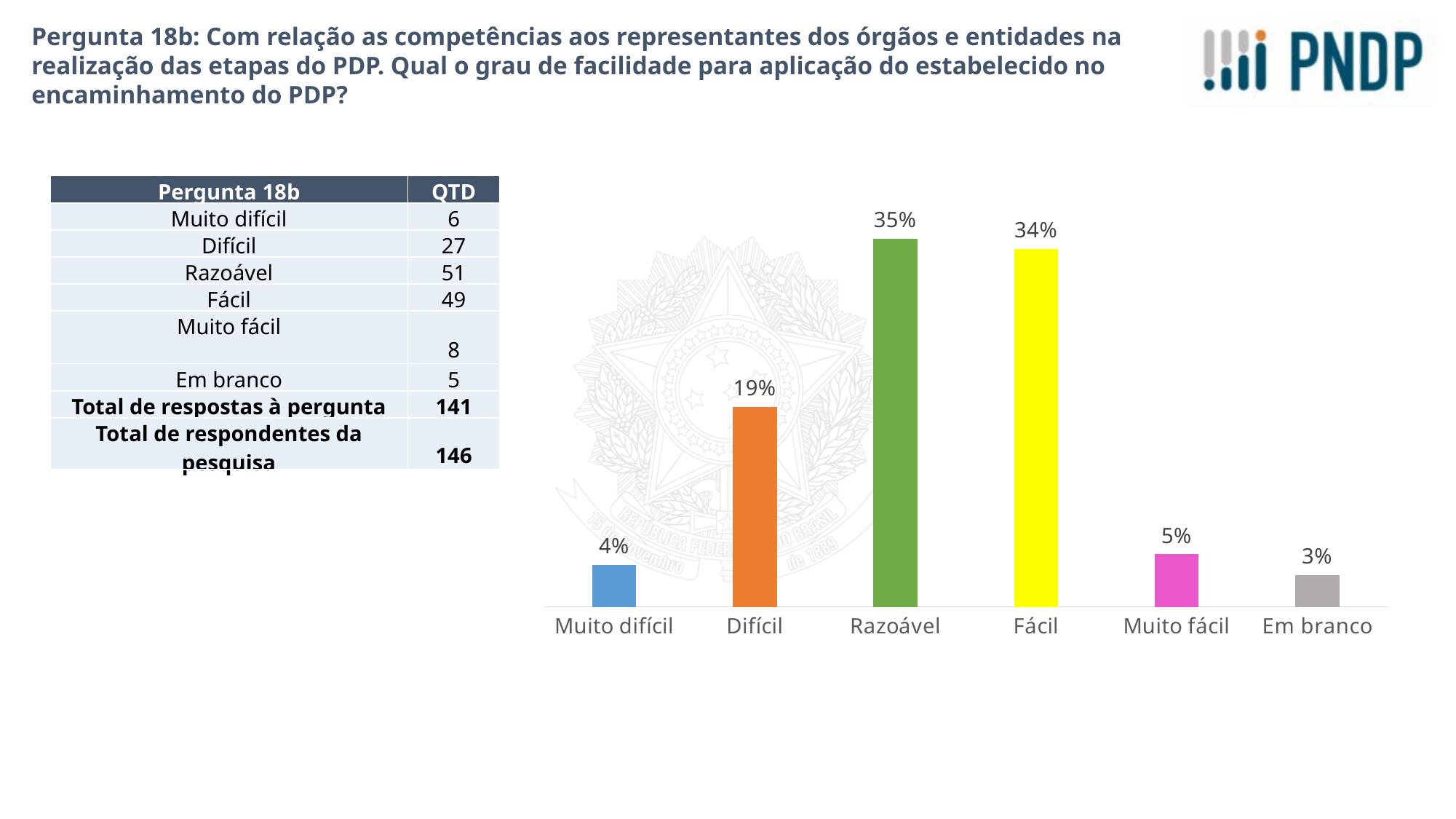
What colour is the bar for Fácil in the chart? Yellow How many categories are shown on the x axis of the bar chart? 6 What percentage is shown for Em branco in the bar chart? 3% What kind of chart is shown on the slide? Bar chart What percentage is shown for Muito fácil in the bar chart? 5% What percentage is shown for Razoável in the bar chart? 35% Which category has the lowest percentage in the bar chart? Em branco What percentage is shown for Difícil in the bar chart? 19% Which category has the highest percentage in the bar chart? Razoável What colour is the bar for Difícil in the chart? Orange Which is larger in the bar chart, Muito difícil or Muito fácil? Muito fácil What is the difference in percentage points between Fácil and Difícil in the bar chart? 15